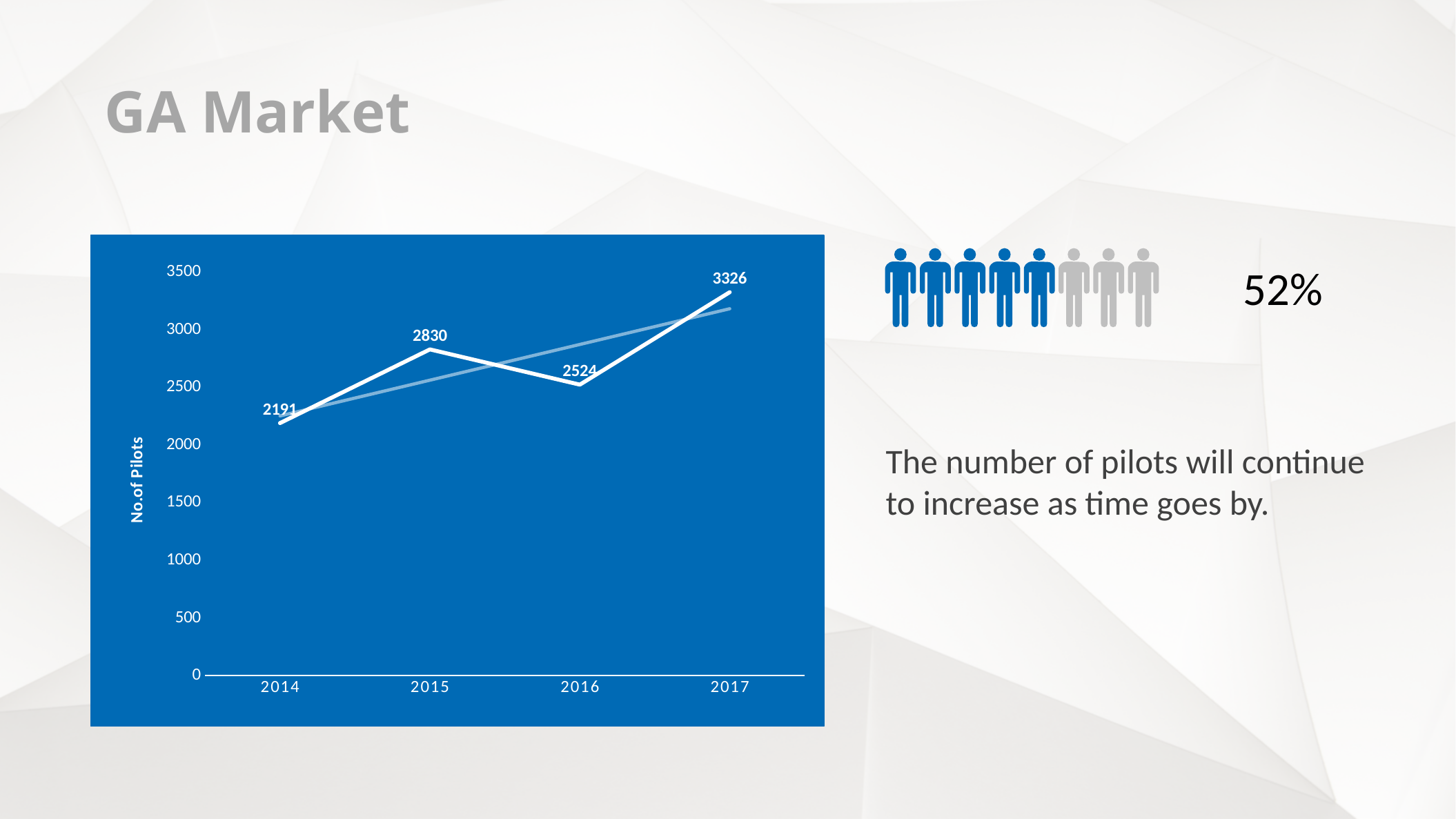
What is the number of pilots in 2014? 2191 Which year has the lowest number of pilots? 2014 What kind of chart is shown on the slide? line chart What is the number of pilots in 2015? 2830 Which year has the highest number of pilots? 2017 What is the number of pilots in 2017? 3326 What is the difference in the number of pilots between 2017 and 2014? 1135 How many years are plotted on the x axis of the chart? 4 What is the number of pilots in 2016? 2524 What is the label of the vertical axis of the chart? No.of Pilots Which year has more pilots, 2015 or 2016? 2015 What is the difference in the number of pilots between 2015 and 2016? 306